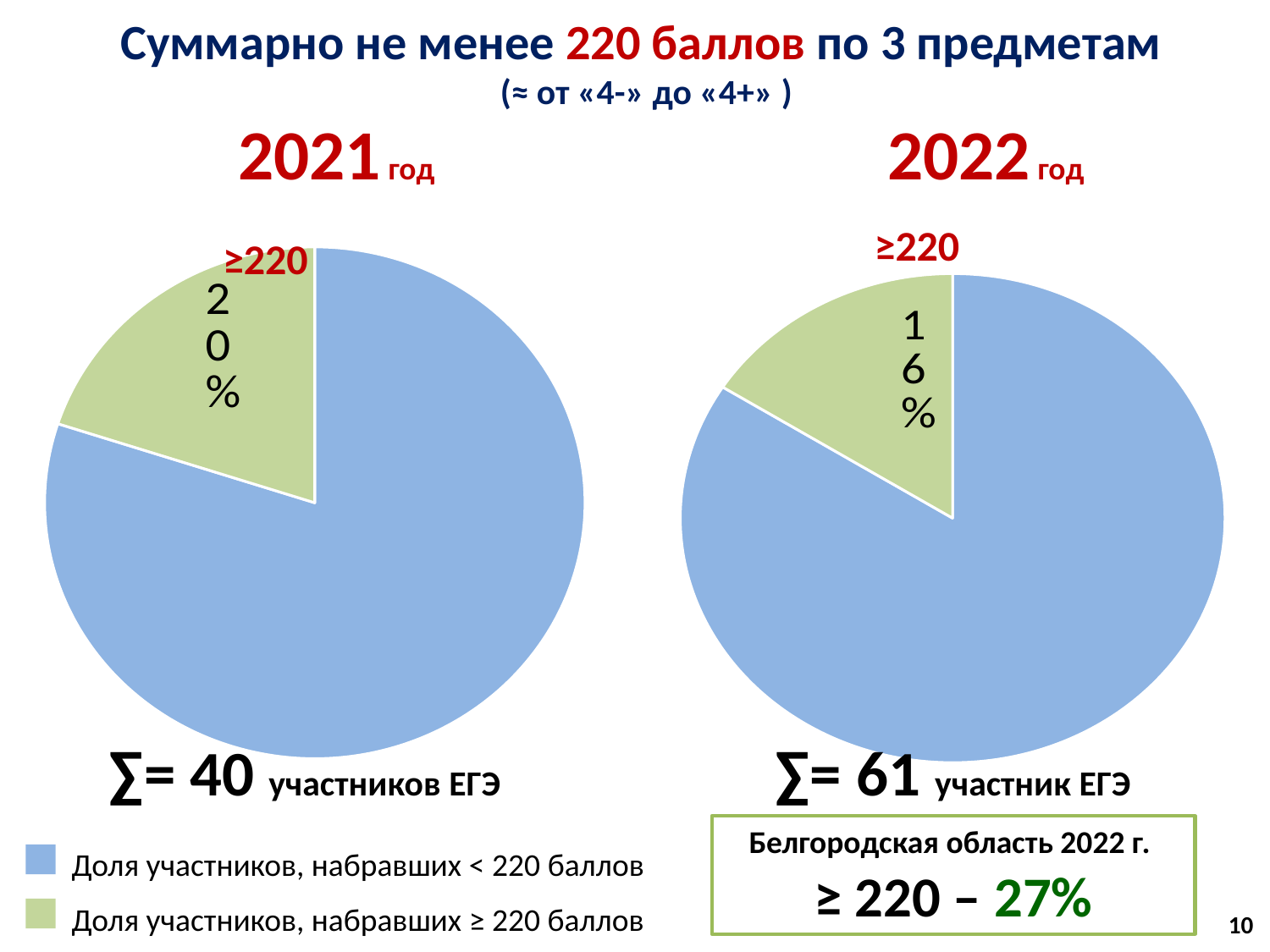
In the 2022 год pie chart, what share of participants scored ≥220 points? 16% Which year's pie chart shows the larger share of participants with ≥220 points, 2021 or 2022? 2021 In the 2022 год pie chart, which slice is the smallest? Доля участников, набравших ≥ 220 баллов How many ЕГЭ participants are shown in total under the 2021 год chart? 40 By how many percentage points does the ≥220 share in the 2021 год chart exceed the ≥220 share in the 2022 год chart? 4 percentage points Did the share of participants with ≥220 points rise or fall from the 2021 год chart to the 2022 год chart? fall How many entries does the legend list? 2 In the 2021 год pie chart, which slice is the largest? Доля участников, набравших < 220 баллов How many ЕГЭ participants are shown in total under the 2022 год chart? 61 In the 2021 год pie chart, what share of participants scored ≥220 points? 20% What kind of chart is used for the 2021 год chart? pie chart How many slices does the 2022 год pie chart have? 2